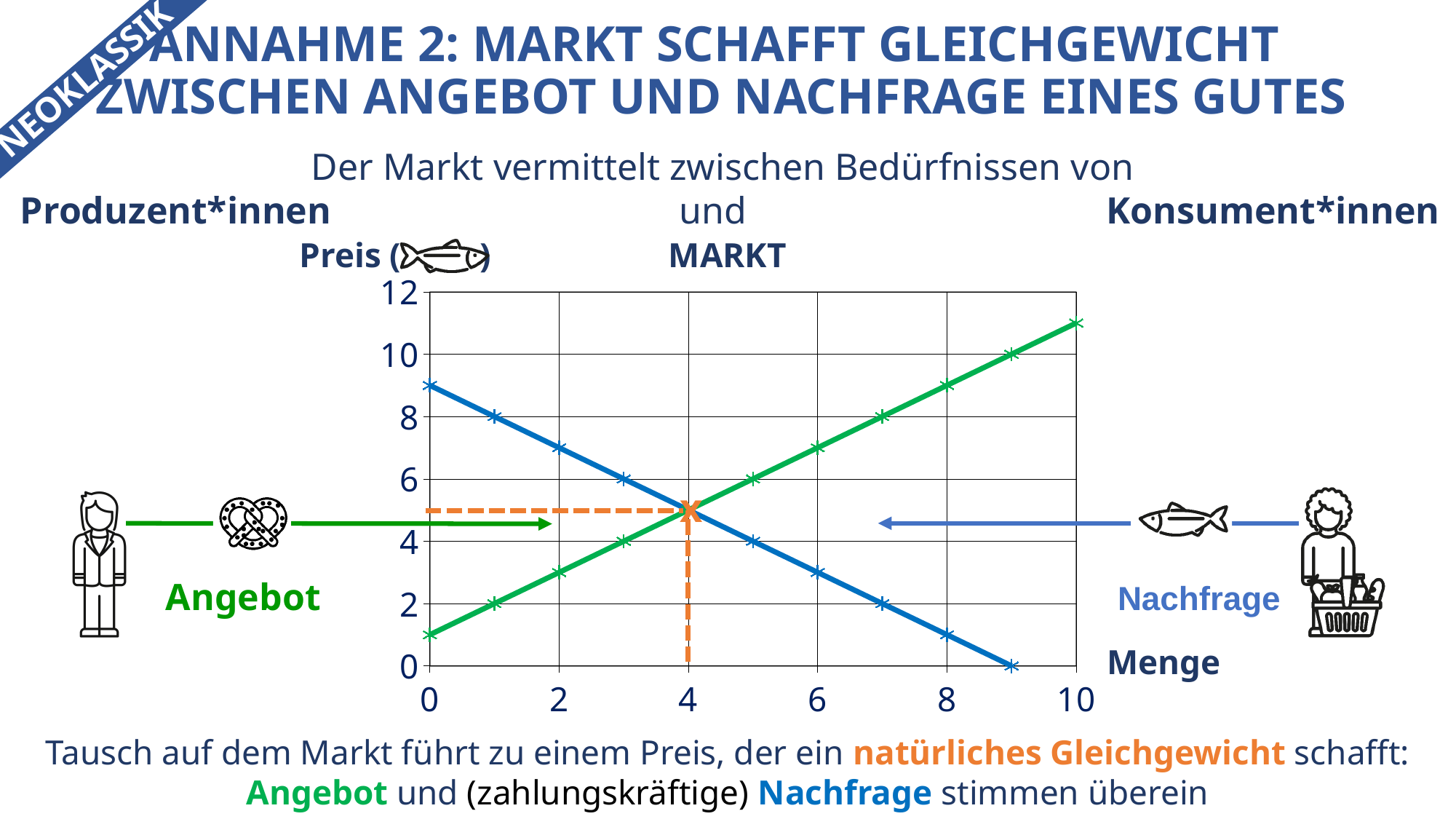
Is the Preis on the Nachfrage curve at Menge 2 greater or less than 6? greater What kind of chart is shown on the slide? line chart Is the Preis on the Angebot curve at Menge 2 greater or less than 4? less How many curves (series) are plotted in the chart? 2 What is the label of the vertical axis of the chart? Preis What is the highest value shown on the vertical axis? 12 At Menge 8, which curve has the higher Preis, Angebot or Nachfrage? Angebot At which Menge value do the Angebot and Nachfrage curves intersect? 4 Is the Preis on the Nachfrage curve at Menge 6 greater or less than 4? less Does the Nachfrage (blue) curve rise or fall as Menge increases? falls At Menge 2, which curve has the higher Preis, Angebot or Nachfrage? Nachfrage Does the Angebot (green) curve rise or fall as Menge increases? rises